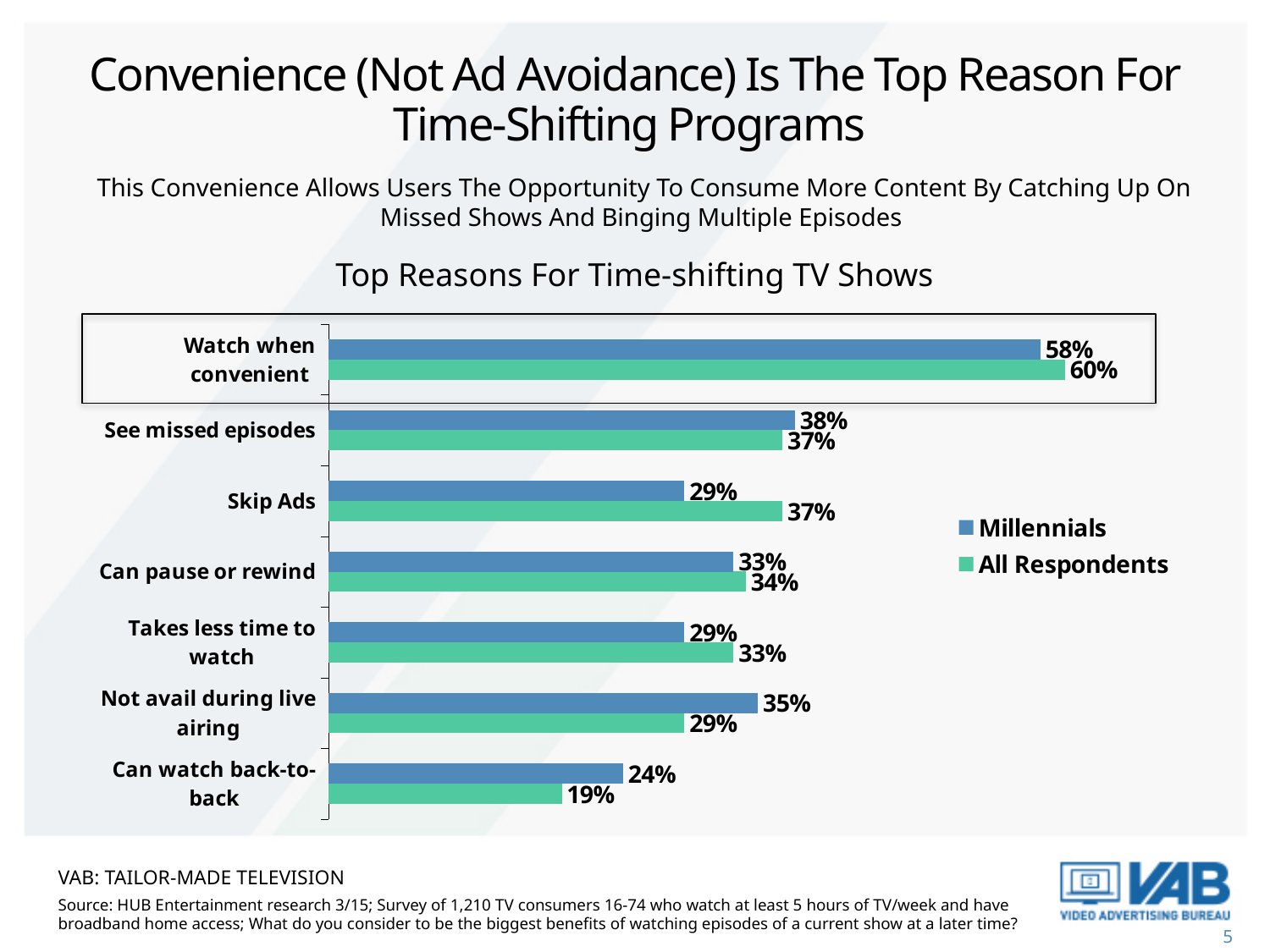
How many series does the legend list? 2 What percentage of Millennials cite "Watch when convenient" as a reason for time-shifting TV shows? 58% Which reason has the highest value among All Respondents? Watch when convenient Which series is shown in green in the chart? All Respondents What is the difference between the All Respondents and Millennials values for "Skip Ads"? 8 percentage points How many reasons (categories) are shown in the chart? 7 What type of chart is shown on the slide? Bar chart What is the Millennials value for "Can watch back-to-back"? 24% For "Not avail during live airing", which group has the larger value, Millennials or All Respondents? Millennials Which reason has the lowest value among Millennials? Can watch back-to-back What is the All Respondents value for "Skip Ads"? 37% What is the title of the chart? Top Reasons For Time-shifting TV Shows